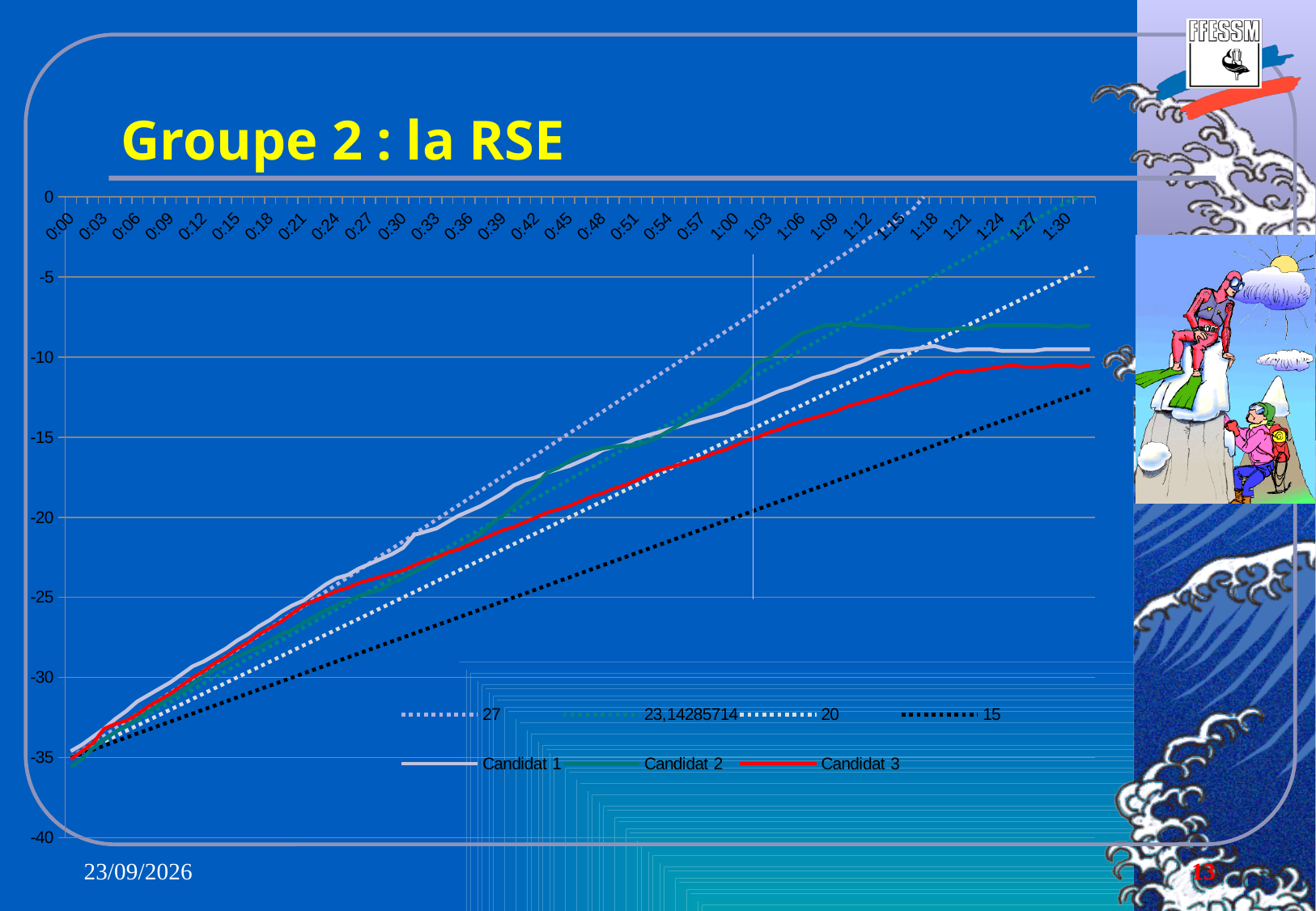
Is the value for Candidat 3 at 1:30 greater or less than -15? greater Is the value for Candidat 2 at 0:00 greater or less than -30? less How many series does the chart legend list? 7 Which colour is used for the Candidat 3 line? red Is the value for Candidat 2 at 1:30 greater or less than -10? greater Do the Candidat lines rise or fall along the x axis from 0:00 to 1:30? rise What is the lowest value shown on the vertical axis? -40 At 1:30, which line is higher, Candidat 2 or Candidat 3? Candidat 2 What kind of chart is shown on the slide? line chart Which of the three Candidat lines ends highest at 1:30? Candidat 2 What is the last time label shown on the x axis? 1:30 What is the title of the slide containing the chart? Groupe 2 : la RSE